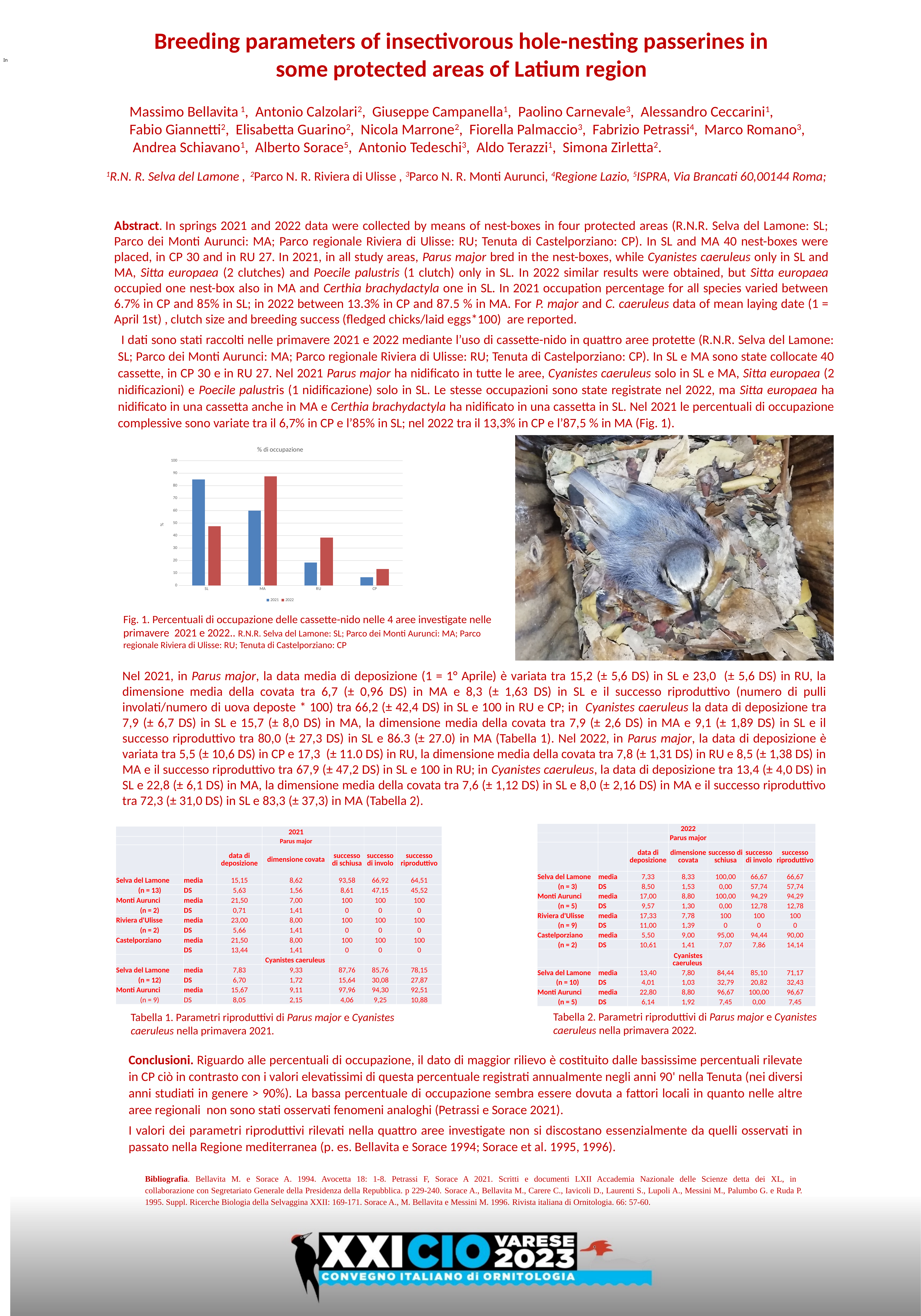
In the "% di occupazione" chart, do the 2021 values rise or fall from SL to CP along the x axis? fall In the "% di occupazione" chart, which is larger for MA: the 2021 value or the 2022 value? 2022 Which area has the lowest occupation percentage for 2021 in the "% di occupazione" chart? CP In the "% di occupazione" chart, is the 2022 value for RU greater or less than 30? greater How many areas (categories) are shown on the x axis of the "% di occupazione" chart? 4 What kind of chart is shown under the title "% di occupazione"? bar chart Which area has the highest occupation percentage for 2021 in the "% di occupazione" chart? SL In the "% di occupazione" chart, is the 2021 value for CP greater or less than 10? less In the "% di occupazione" chart, which is larger for SL: the 2021 value or the 2022 value? 2021 Which area has the highest occupation percentage for 2022 in the "% di occupazione" chart? MA How many series does the legend of the "% di occupazione" chart list? 2 In the "% di occupazione" chart, is the 2021 value for SL greater or less than 80? greater